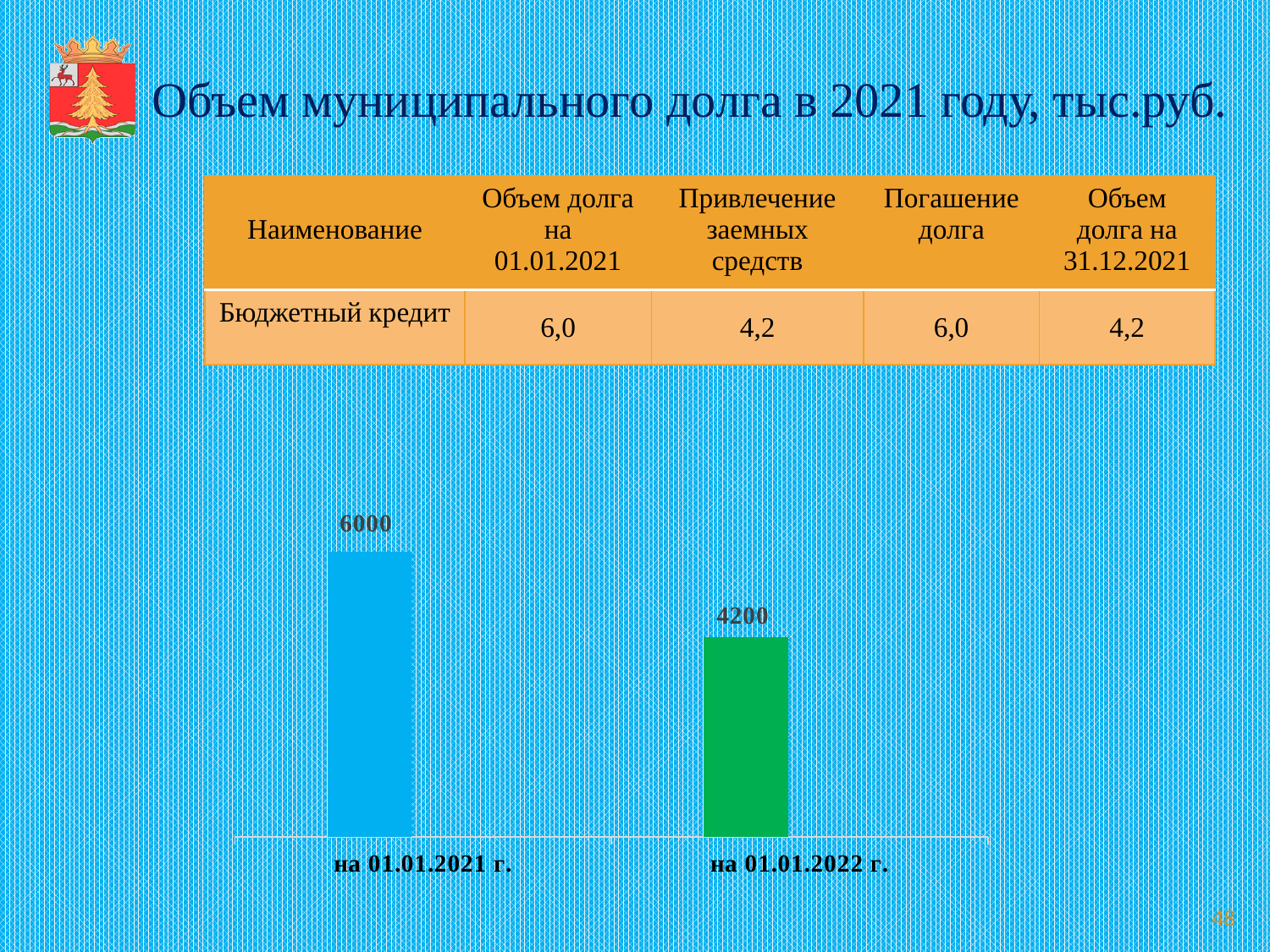
Which is larger: the value for "на 01.01.2021 г." or the value for "на 01.01.2022 г."? на 01.01.2021 г. Which category has the lowest value? на 01.01.2022 г. What is the difference between the value for "на 01.01.2021 г." and the value for "на 01.01.2022 г."? 1800 Which category has the highest value? на 01.01.2021 г. What colour is the bar for "на 01.01.2021 г."? blue What is the value for "на 01.01.2022 г."? 4200 Do the values rise or fall from "на 01.01.2021 г." to "на 01.01.2022 г."? fall What kind of chart is shown on the slide? bar chart What is the value for "на 01.01.2021 г."? 6000 How many categories are shown in the chart? 2 What colour is the bar for "на 01.01.2022 г."? green